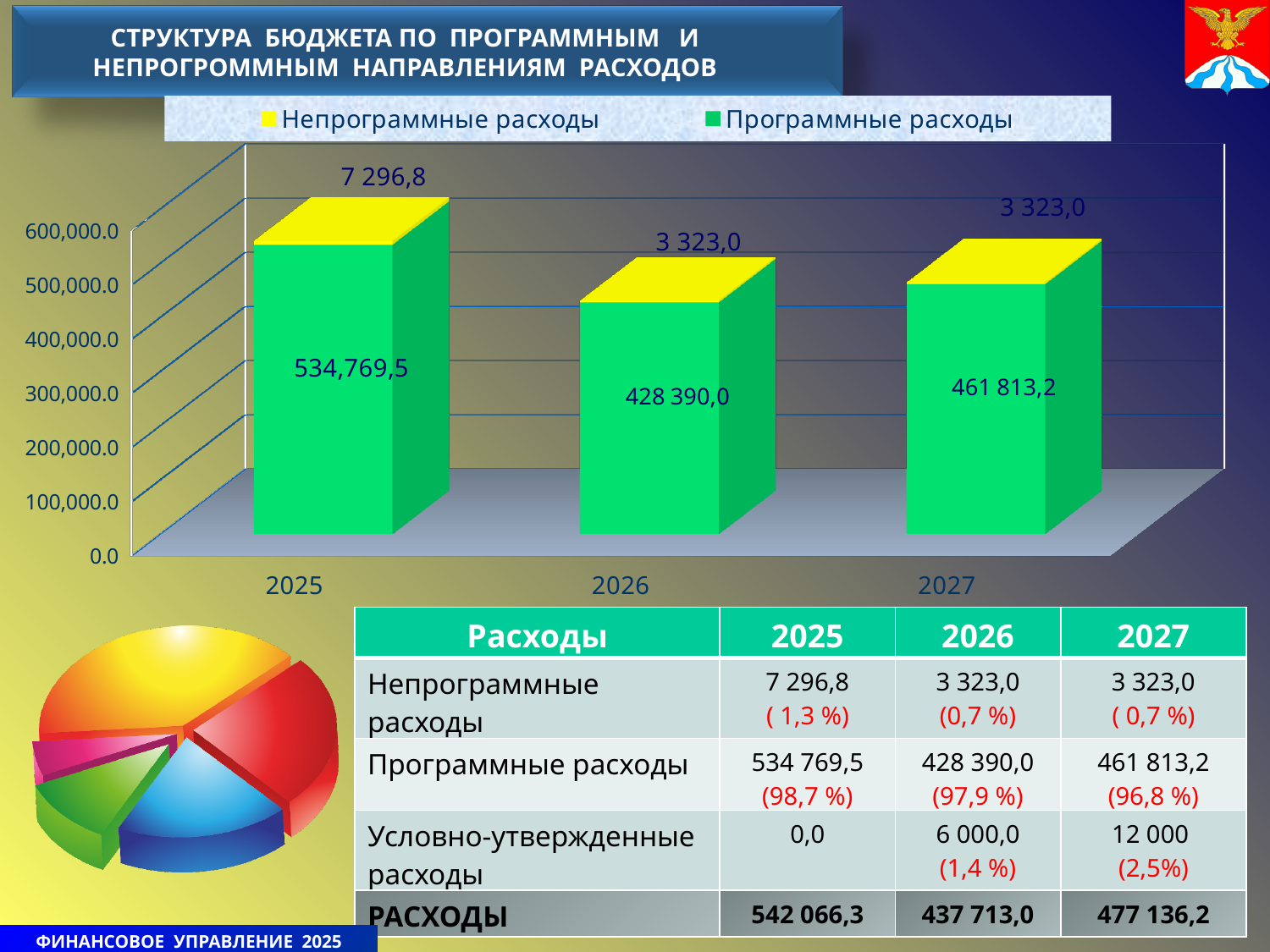
What is the value of Программные расходы for 2027 in the bar chart? 461 813,2 How many series does the chart legend list? 2 What is the difference between Программные расходы in 2027 and in 2026? 33 423,2 In which year is Программные расходы lowest? 2026 What is the value of Программные расходы for 2026 in the bar chart? 428 390,0 Which is larger: Непрограммные расходы in 2025 or in 2027? 2025 Which colour represents Непрограммные расходы in the bar chart? yellow How many years (categories) are shown on the x axis of the bar chart? 3 In which year is Программные расходы highest? 2025 Does Программные расходы rise or fall from 2025 to 2026? fall What is the value of Непрограммные расходы for 2025 in the bar chart? 7 296,8 What kind of chart is shown on the slide? stacked bar chart